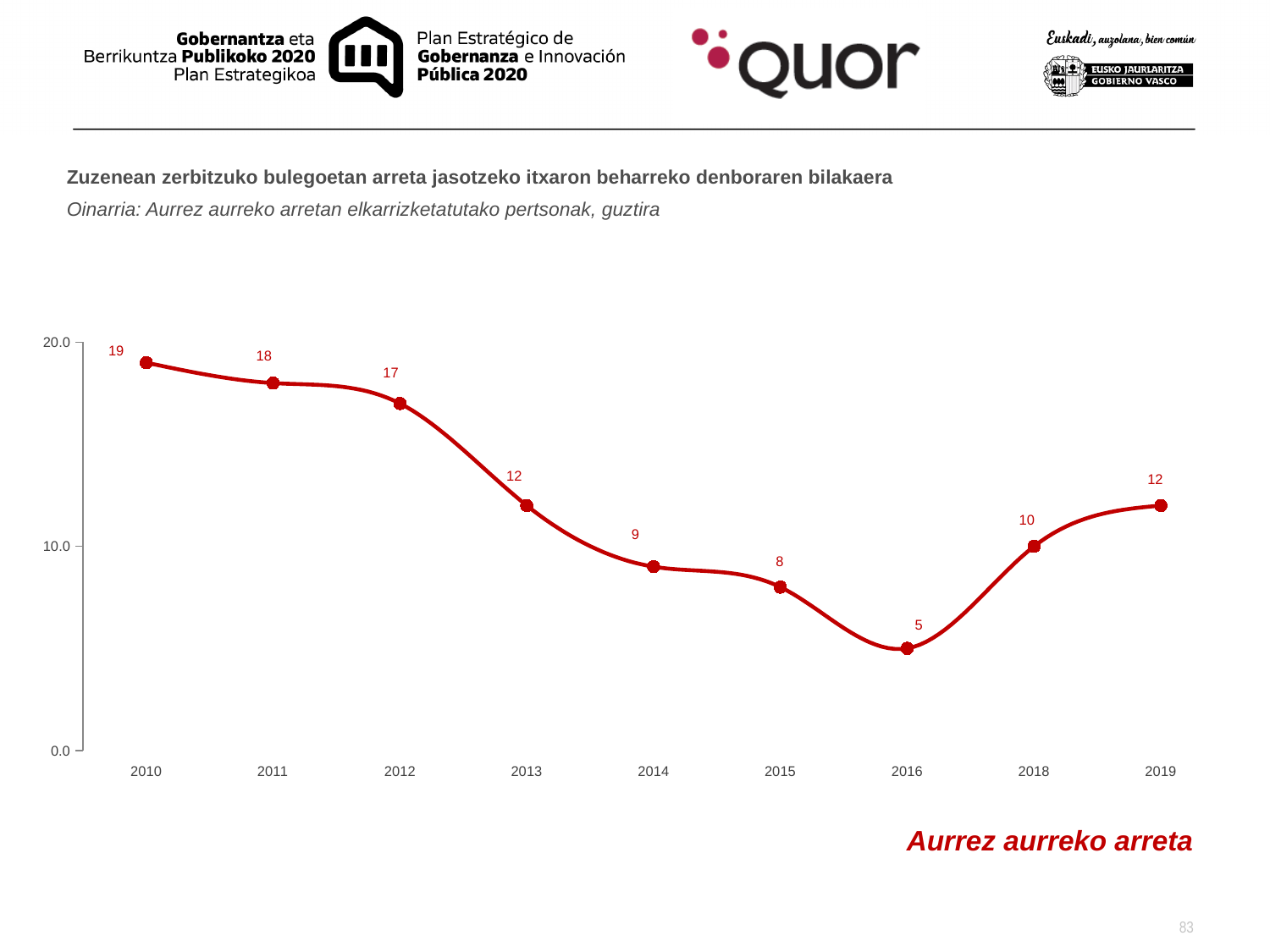
What is the value for 2016? 5 Do the values rise or fall from 2010 to 2016? fall What is the difference between the values for 2010 and 2016? 14 Is the value for 2014 greater or less than 10.0? less Which year has the highest value? 2010 How many years are plotted on the x axis? 9 Which is larger, the value for 2013 or the value for 2015? 2013 Which year has the lowest value? 2016 What kind of chart is shown? line chart What is the value for 2010? 19 What is the difference between the values for 2019 and 2018? 2 What is the value for 2018? 10